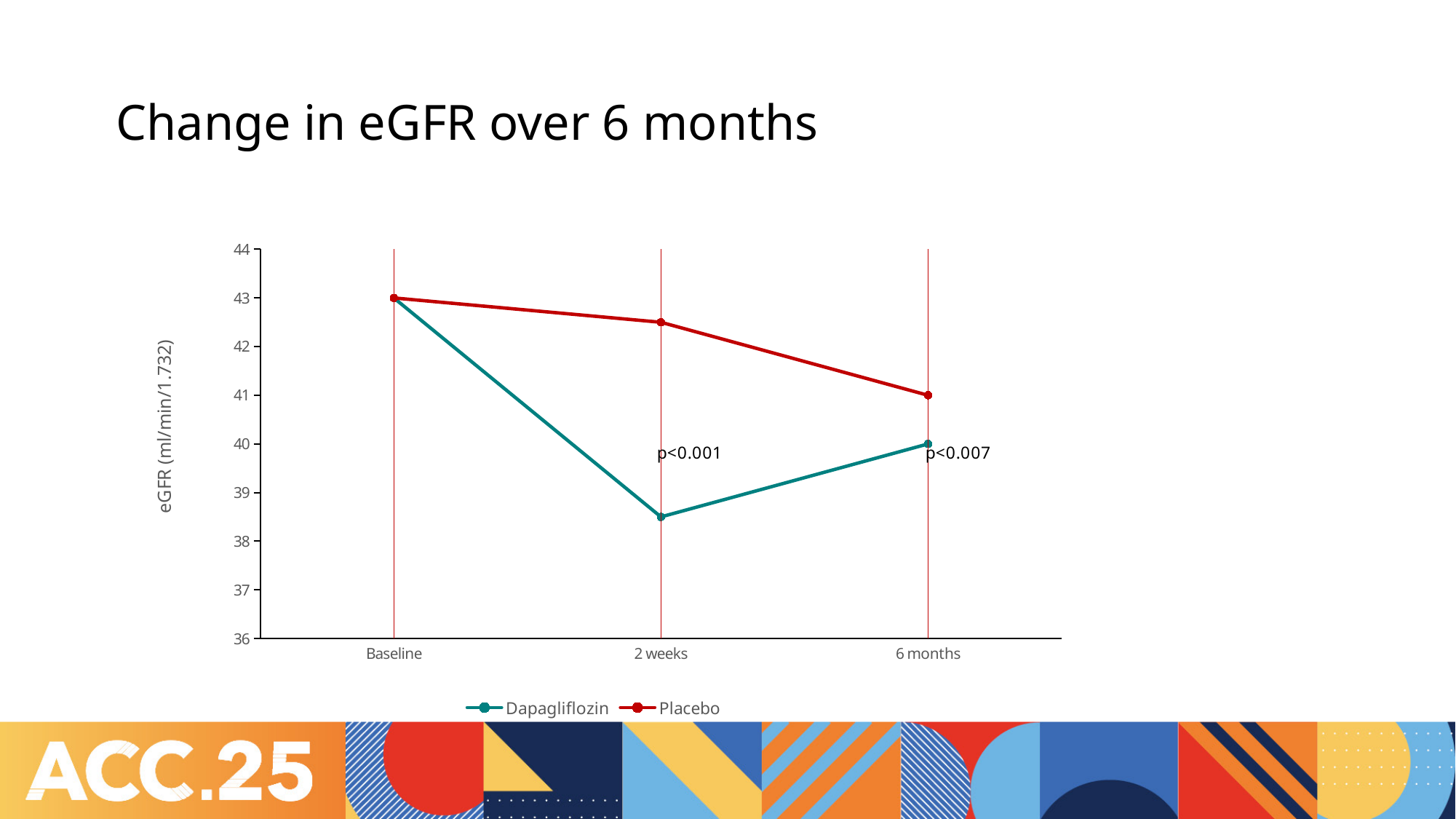
At which time point is the Dapagliflozin value lowest? 2 weeks What is the eGFR value for Placebo at 6 months? 41 Is the value for Dapagliflozin at 2 weeks greater or less than 39? less What is the difference between the Placebo and Dapagliflozin values at 6 months? 1 Does the Placebo series rise or fall from Baseline to 6 months? Fall What is the eGFR value for Dapagliflozin at 6 months? 40 How many time points are plotted along the x axis? 3 Is the value for Placebo at 2 weeks greater or less than 42? greater At 6 months, which series has the higher eGFR value, Dapagliflozin or Placebo? Placebo How many series does the legend list? 2 What kind of chart is shown on the slide? Line chart What is the eGFR value for Placebo at Baseline? 43